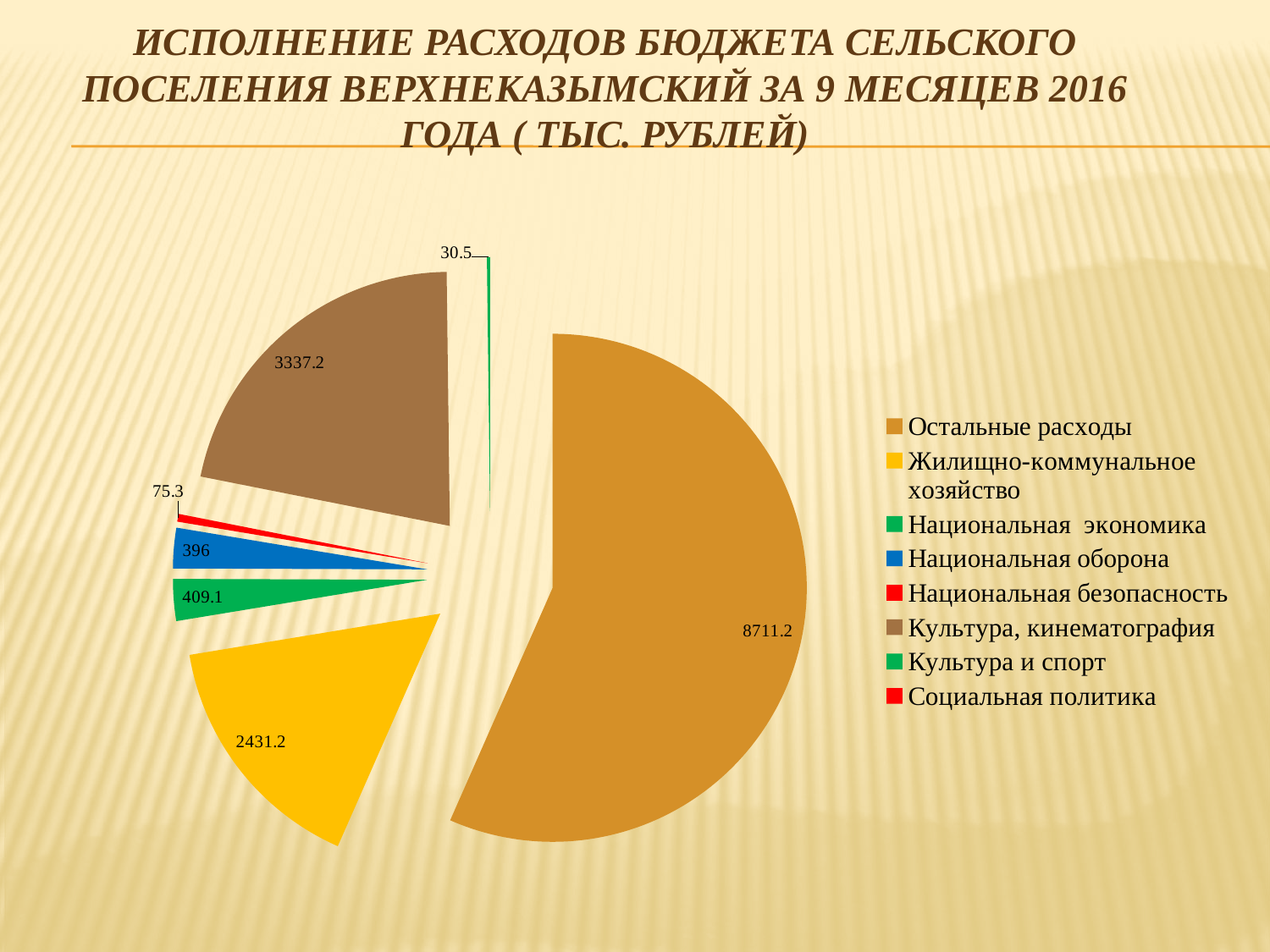
Which category has the largest slice of the pie? Остальные расходы What is the value for Культура, кинематография? 3337.2 What is the value for Жилищно-коммунальное хозяйство? 2431.2 What is the value for Национальная безопасность? 75.3 What is the value for Остальные расходы? 8711.2 What colour is the slice for Остальные расходы? Orange How many categories does the legend list? 8 What is the difference between the values for Остальные расходы and Культура, кинематография? 5374 What is the value for Национальная экономика? 409.1 What type of chart is shown on the slide? Pie chart What is the value for Национальная оборона? 396 Which is larger, the value for Культура, кинематография or the value for Жилищно-коммунальное хозяйство? Культура, кинематография